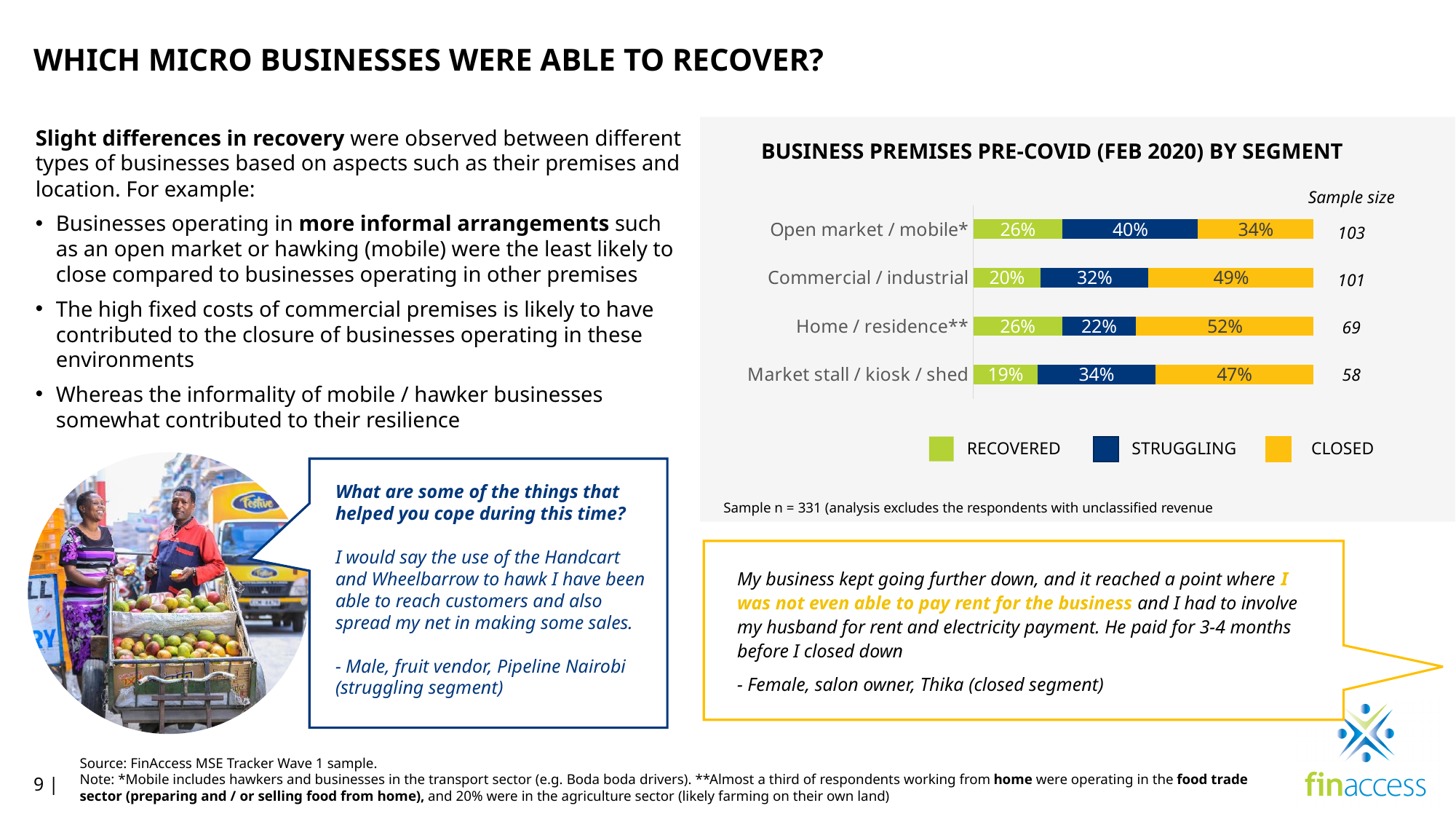
Which is larger: the STRUGGLING share for Commercial / industrial or the STRUGGLING share for Market stall / kiosk / shed? Market stall / kiosk / shed What is the sample size for Market stall / kiosk / shed? 58 What type of chart is shown on the slide? Stacked bar chart Which segment has the highest STRUGGLING share? Open market / mobile Which segment has the lowest RECOVERED share? Market stall / kiosk / shed Which segment has the highest CLOSED share? Home / residence What is the difference between the CLOSED share for Home / residence and the CLOSED share for Open market / mobile? 18 percentage points What is the RECOVERED share for Open market / mobile? 26% What is the STRUGGLING share for Home / residence? 22% How many segments (categories) are shown in the chart? 4 How many series does the legend list? 3 What is the CLOSED share for Commercial / industrial? 49%